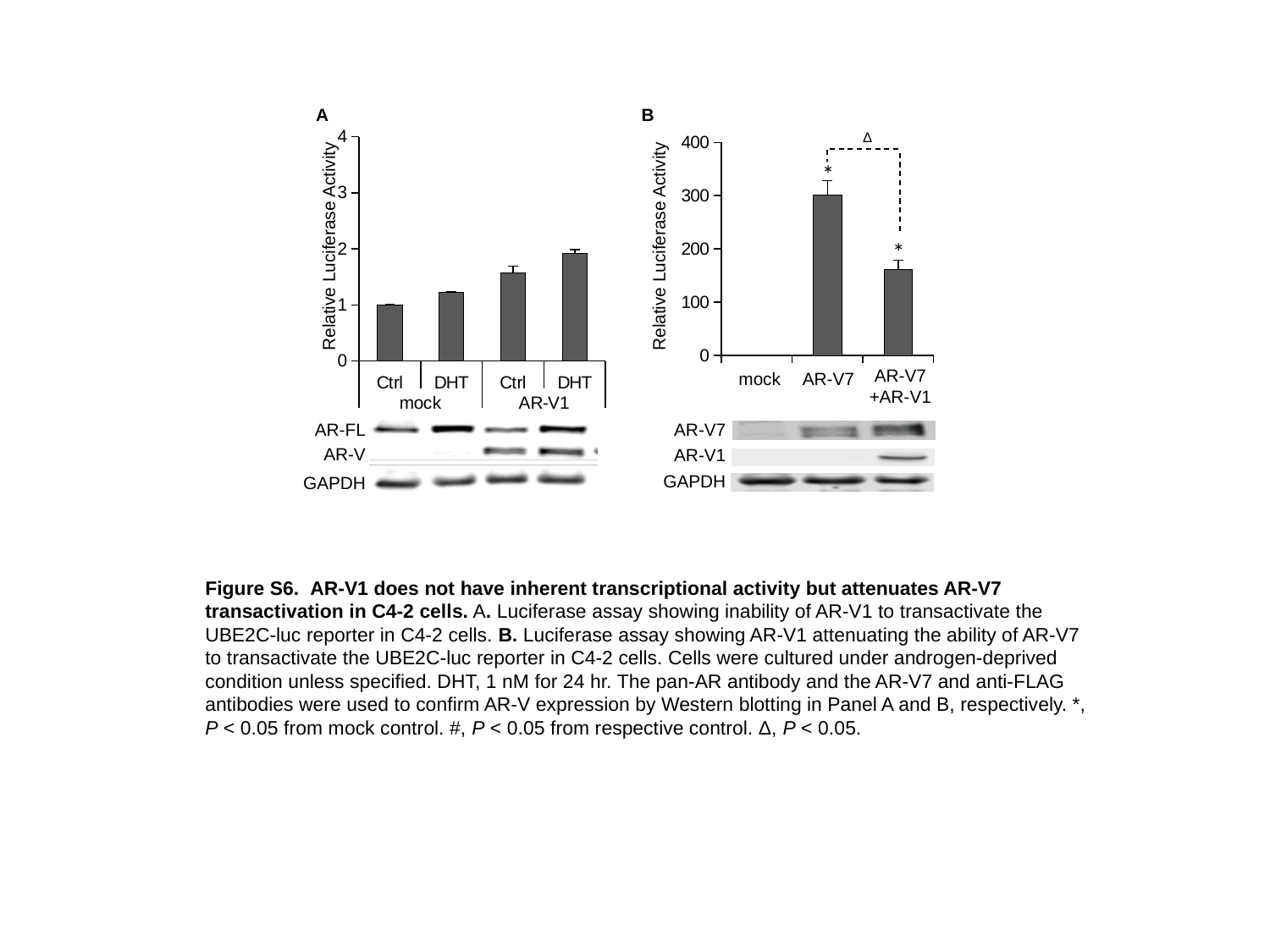
What kind of chart is Panel A? bar chart In Panel B, how many categories are on the x axis? 3 In Panel A, which bar has the highest relative luciferase activity? AR-V1 DHT In Panel A, do the bar values rise or fall from left to right? rise In Panel B, which category has the highest relative luciferase activity? AR-V7 In Panel A, how many bars are plotted? 4 In Panel A, is the value for AR-V1 Ctrl greater or less than 1? greater What is the y-axis label of Panel B? Relative Luciferase Activity In Panel B, is the value for AR-V7+AR-V1 greater or less than 200? less In Panel A, which bar has the lowest relative luciferase activity? mock Ctrl In Panel A, which is larger, the DHT bar under mock or the DHT bar under AR-V1? DHT under AR-V1